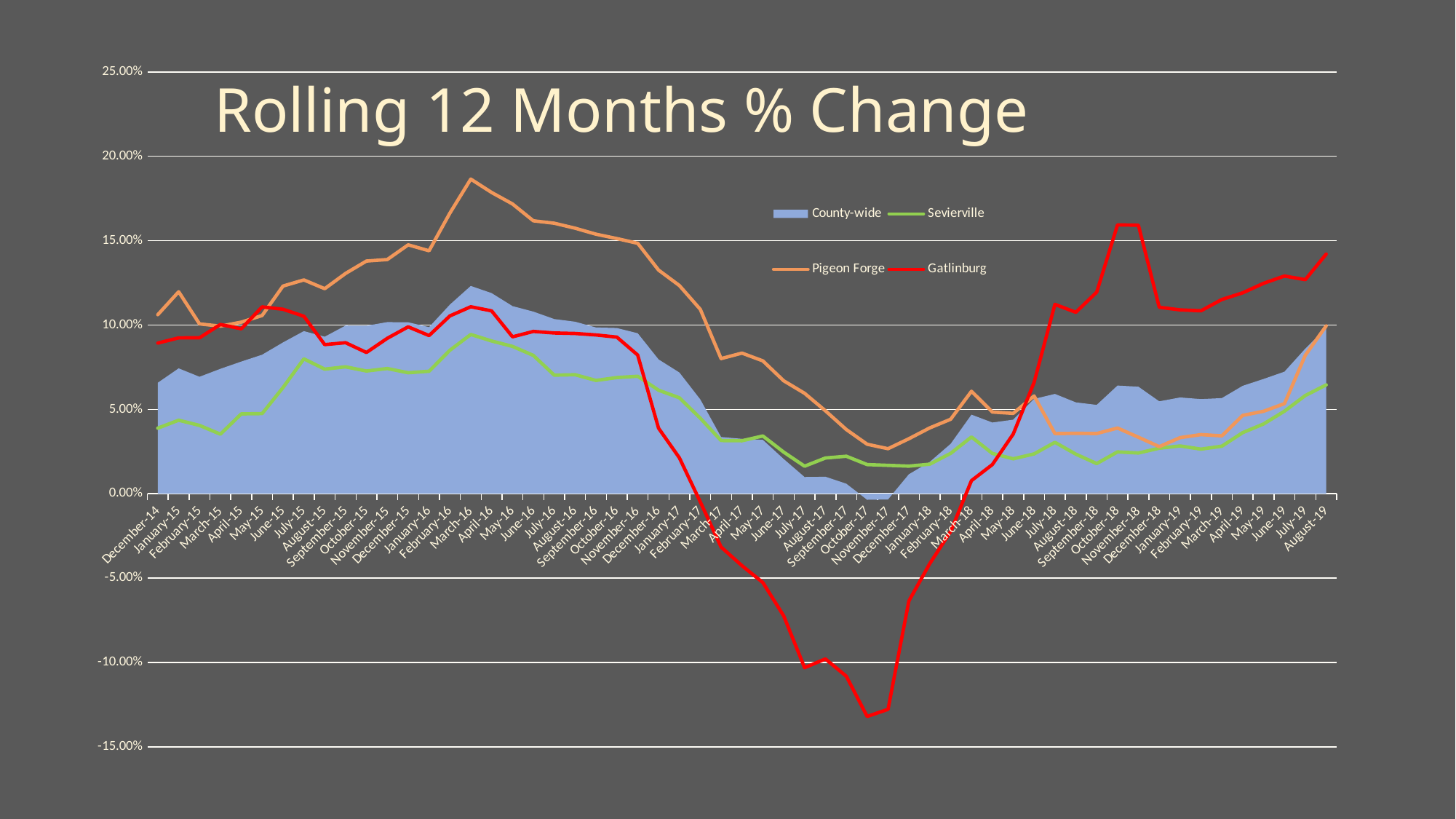
Is the Pigeon Forge value for March-16 greater or less than 15.00%? greater Does the Gatlinburg line rise or fall between June-18 and October-18? rise Is the Gatlinburg value for October-17 greater or less than -10.00%? less In August-19, which is higher: Gatlinburg or Sevierville? Gatlinburg Which series is drawn as a filled area rather than a line? County-wide Is the County-wide value for April-16 greater or less than 10.00%? greater How many series does the legend list? 4 Which series reaches the highest value anywhere on the chart? Pigeon Forge Which series reaches the lowest value anywhere on the chart? Gatlinburg Does the Pigeon Forge line rise or fall between March-16 and November-17? fall What is the title of the chart? Rolling 12 Months % Change